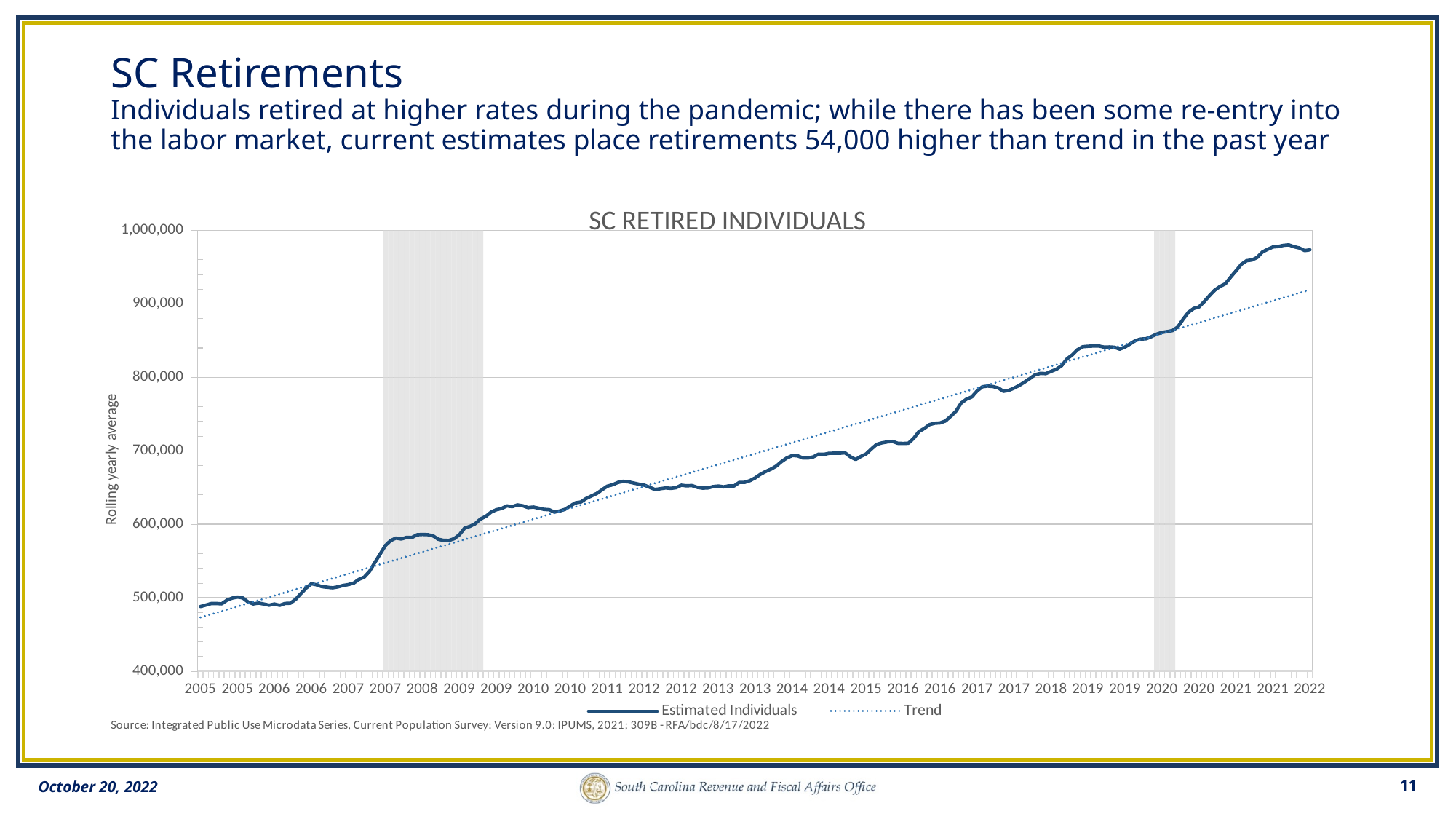
At 2014, which series is higher, Estimated Individuals or Trend? Trend Does the Estimated Individuals line generally rise or fall from 2005 to 2022? Rise What kind of chart is shown on the slide? Line chart At 2022, which series is higher, Estimated Individuals or Trend? Estimated Individuals In which year does the Estimated Individuals line reach its highest point? 2022 How many series does the chart's legend list? 2 Is the value of Estimated Individuals at 2022 greater or less than 900,000? greater Is the value of Estimated Individuals at 2010 greater or less than 600,000? greater What is the title of the chart? SC RETIRED INDIVIDUALS Is the value of Estimated Individuals at 2020 greater or less than 800,000? greater What is the label on the vertical axis of the chart? Rolling yearly average